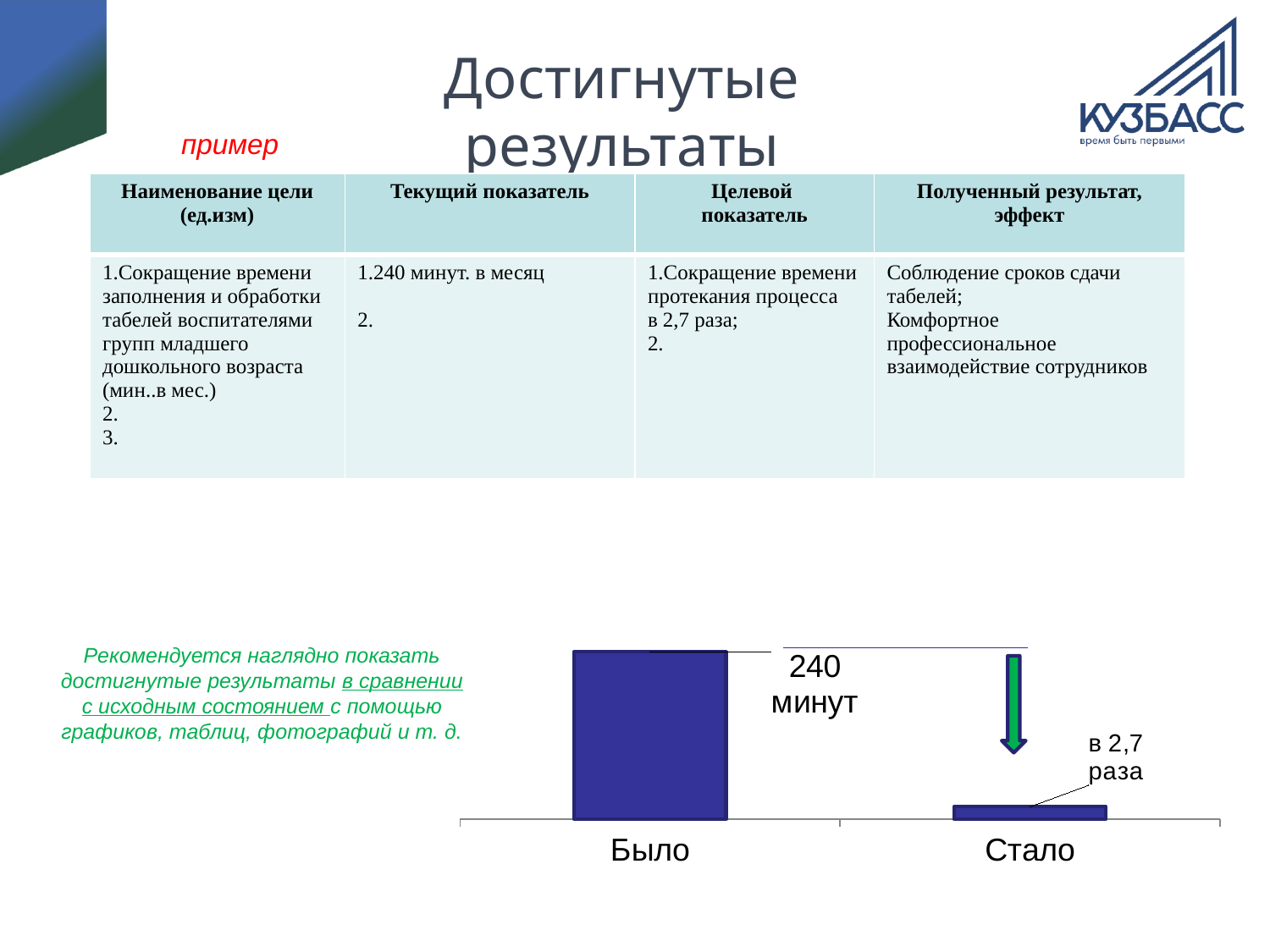
Which category in the chart has the lowest bar? Стало What kind of chart is shown on the slide? Bar chart Which bar is taller in the chart, "Было" or "Стало"? Было What annotation is written next to the "Стало" bar in the chart? в 2,7 раза What colour are the bars in the chart? Dark blue Which category in the chart has the highest bar? Было Do the bar values rise or fall from "Было" to "Стало"? Fall What value is labelled on the "Было" bar in the chart? 240 минут How many categories are shown on the x axis of the chart? 2